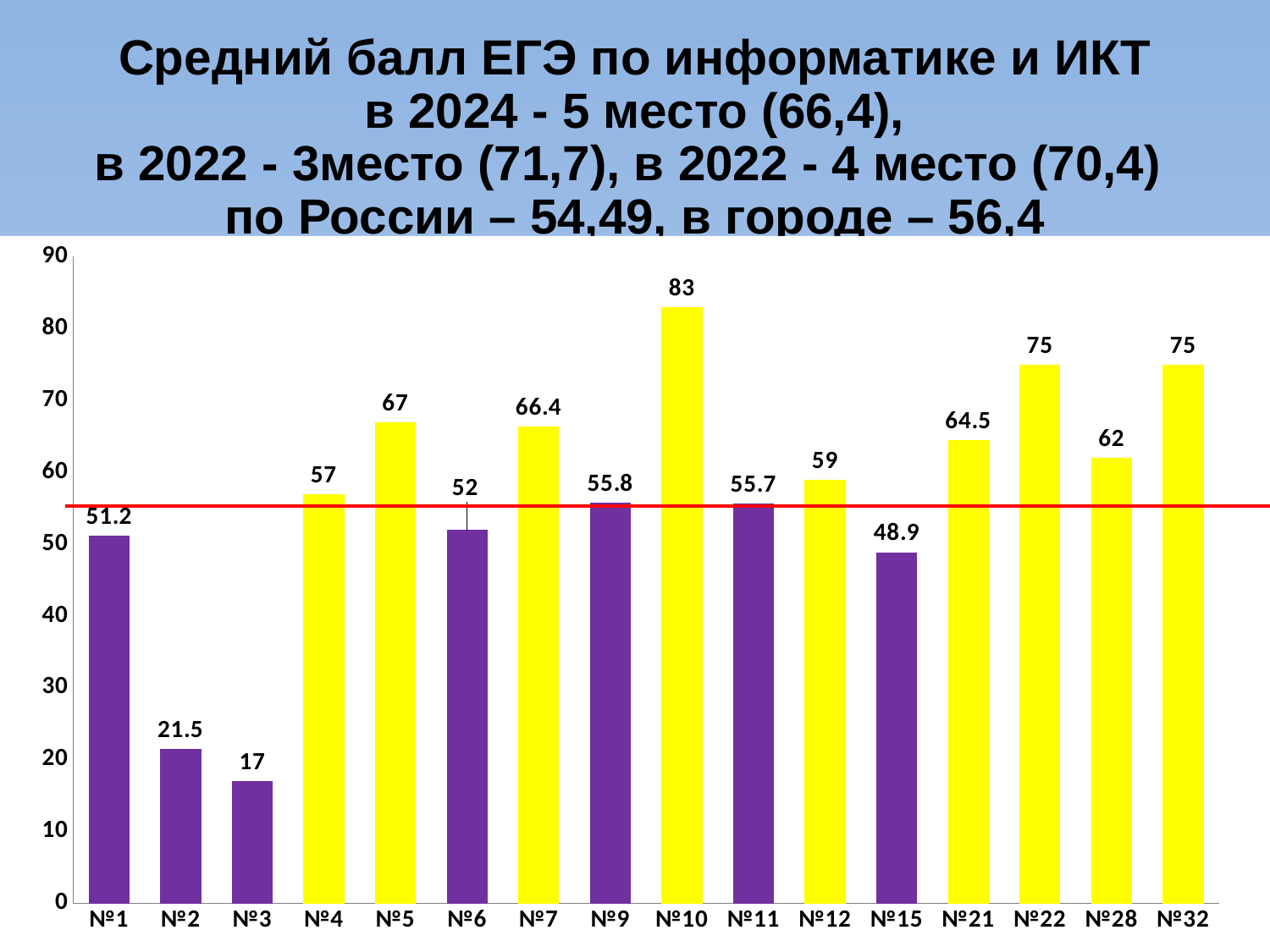
What is the value for №15? 48.9 Is the value for №2 greater or less than 30? less Which is larger, the value for №21 or the value for №12? №21 What kind of chart is shown on the slide? bar chart What colour are the bars for №22 and №32? yellow What is the difference between the values for №5 and №28? 5 Which category has the highest value? №10 Which category has the lowest value? №3 What is the value for №7? 66.4 What is the difference between the values for №10 and №3? 66 How many categories are shown on the x axis? 16 What is the value for №10? 83